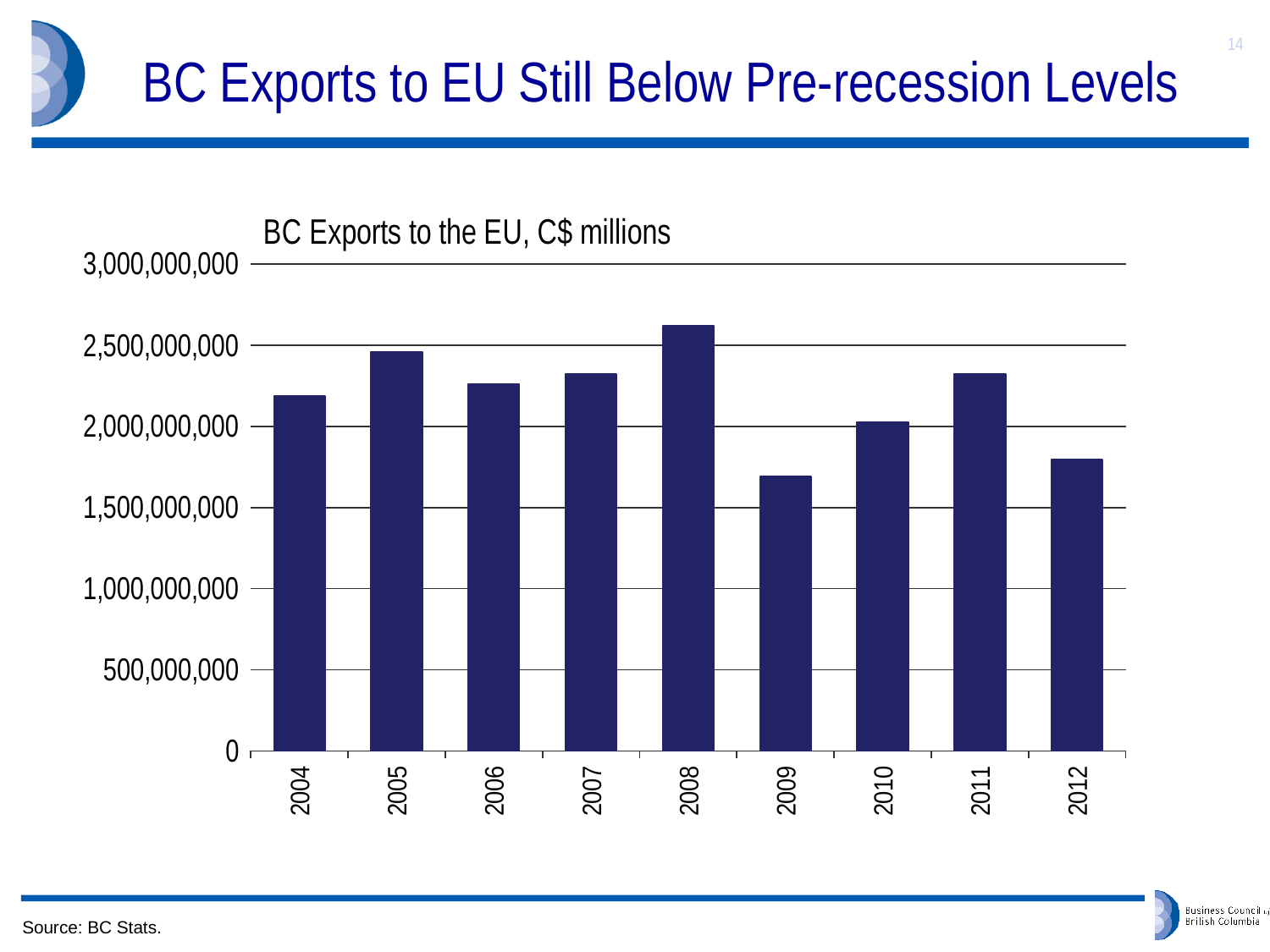
Which year has the larger value, 2005 or 2006? 2005 Is the value for 2009 greater or less than 2,000,000,000? less Is the value for 2008 greater or less than 2,500,000,000? greater Which year has the highest value of BC exports to the EU? 2008 Is the value for 2005 greater or less than 2,000,000,000? greater Which year has the lowest value of BC exports to the EU? 2009 Do BC exports to the EU rise or fall from 2008 to 2009? fall What is the title of the chart? BC Exports to the EU, C$ millions How many years are plotted on the chart? 9 Which year has the larger value, 2012 or 2008? 2008 What kind of chart is shown on the slide? bar chart